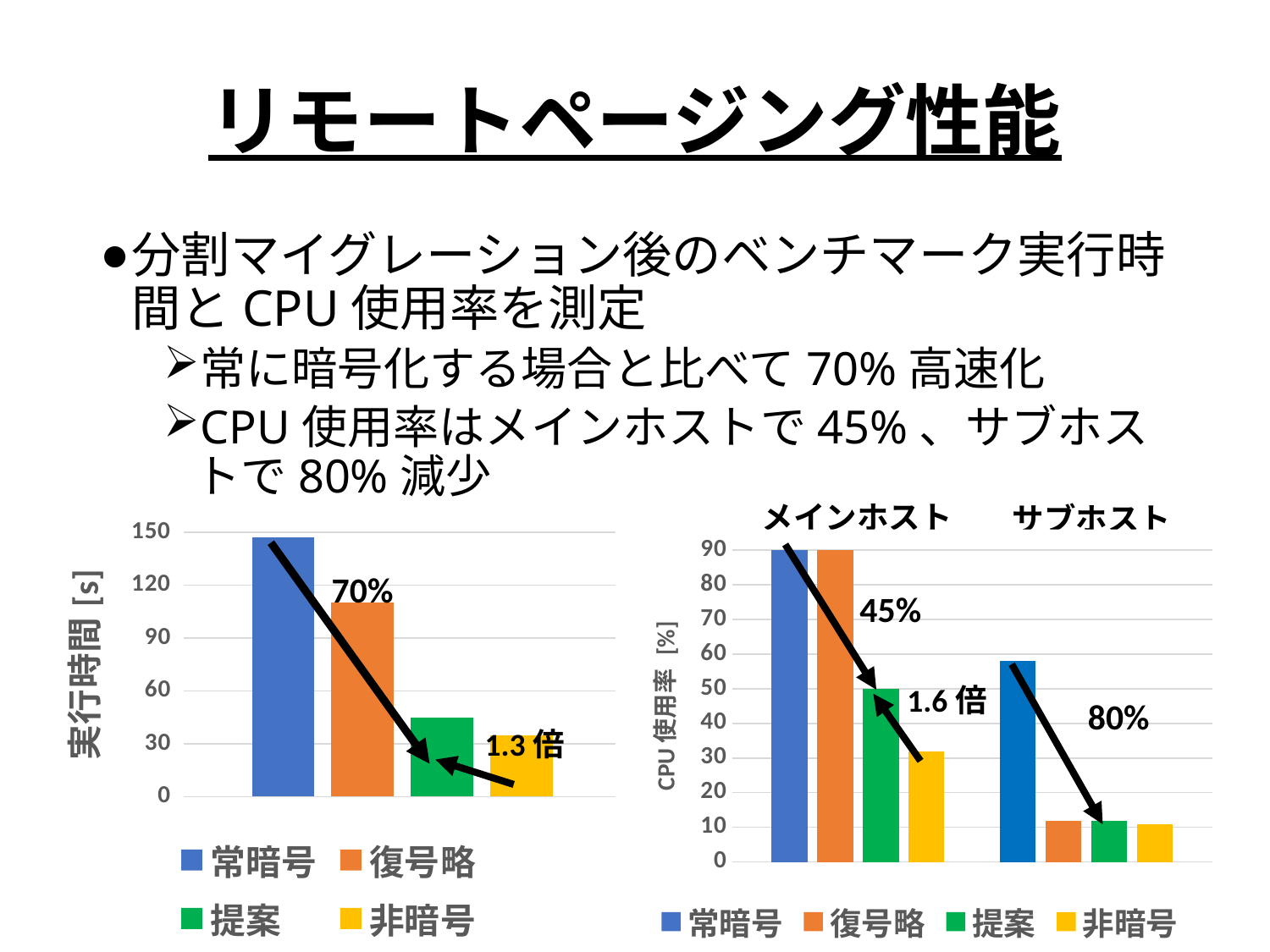
In the right chart (CPU 使用率 [%]), how many category groups are shown on the x axis? 2 What is the y-axis label of the right chart? CPU 使用率 [%] In the right chart (CPU 使用率 [%]), is the value for 提案 at サブホスト greater or less than 20? less How many series does the legend of the left chart (実行時間 [s]) list? 4 In the right chart (CPU 使用率 [%]), is the value for 提案 at メインホスト greater or less than 40? greater In the left chart (実行時間 [s]), which series has the lowest value? 非暗号 In the left chart (実行時間 [s]), which series has the highest value? 常暗号 In the left chart (実行時間 [s]), is the value for 提案 greater or less than 60? less In the right chart (CPU 使用率 [%]), which series has the highest value at サブホスト? 常暗号 In the left chart (実行時間 [s]), which is larger, 常暗号 or 提案? 常暗号 What kind of chart is the left chart (実行時間 [s])? bar chart